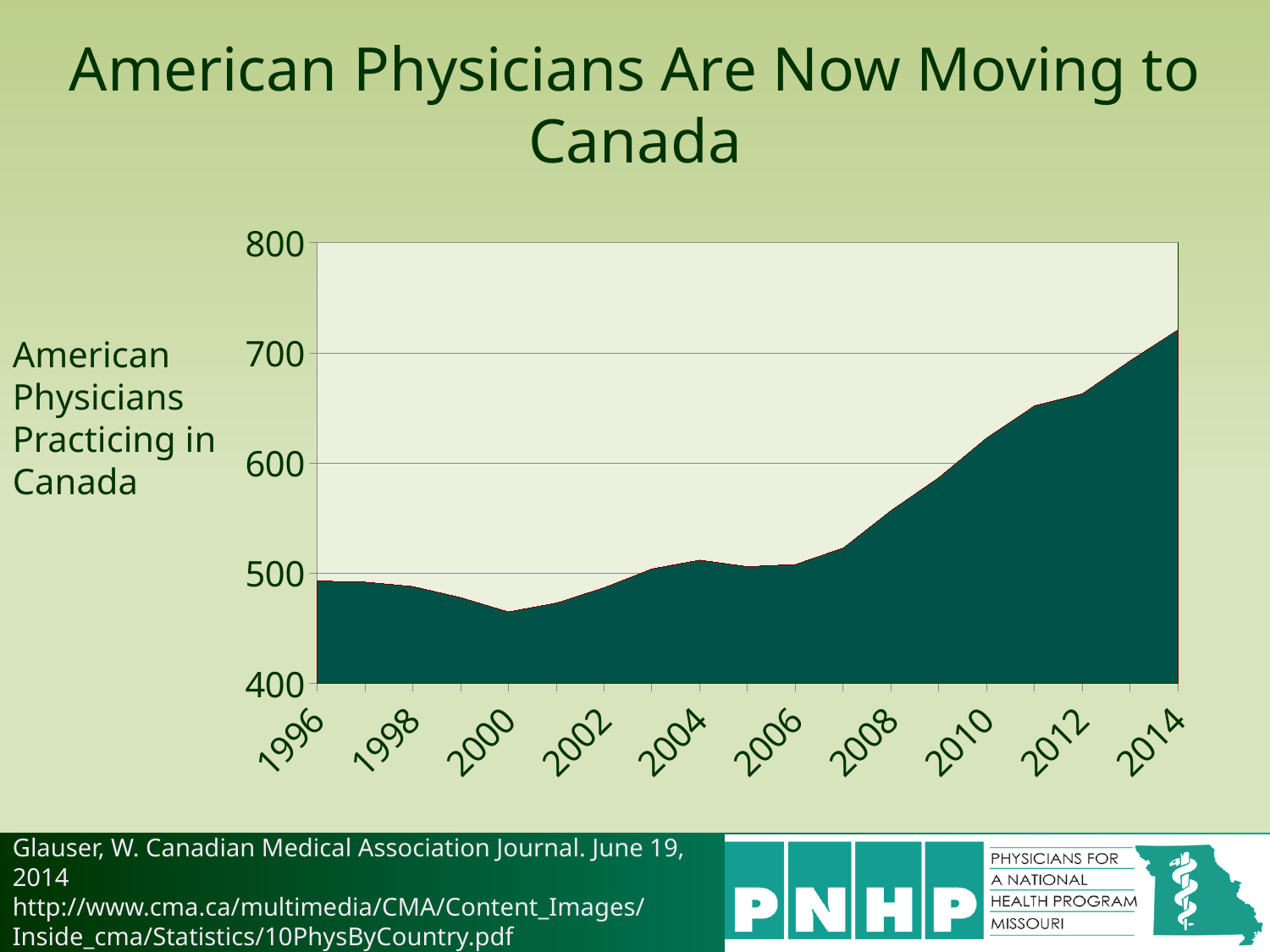
In which labelled year is the number of American physicians practicing in Canada lowest? 2000 What label is given to the vertical axis of the chart? American Physicians Practicing in Canada Is the value for 2008 greater or less than 500? greater What kind of chart is shown on the slide? Area chart In which labelled year is the number of American physicians practicing in Canada highest? 2014 Is the value for 2012 greater or less than 600? greater Is the value for 2006 greater or less than 600? less Overall, do the values rise or fall from 1996 to 2014? Rise How many year labels are shown on the x axis? 10 Which year has the larger value, 1996 or 2014? 2014